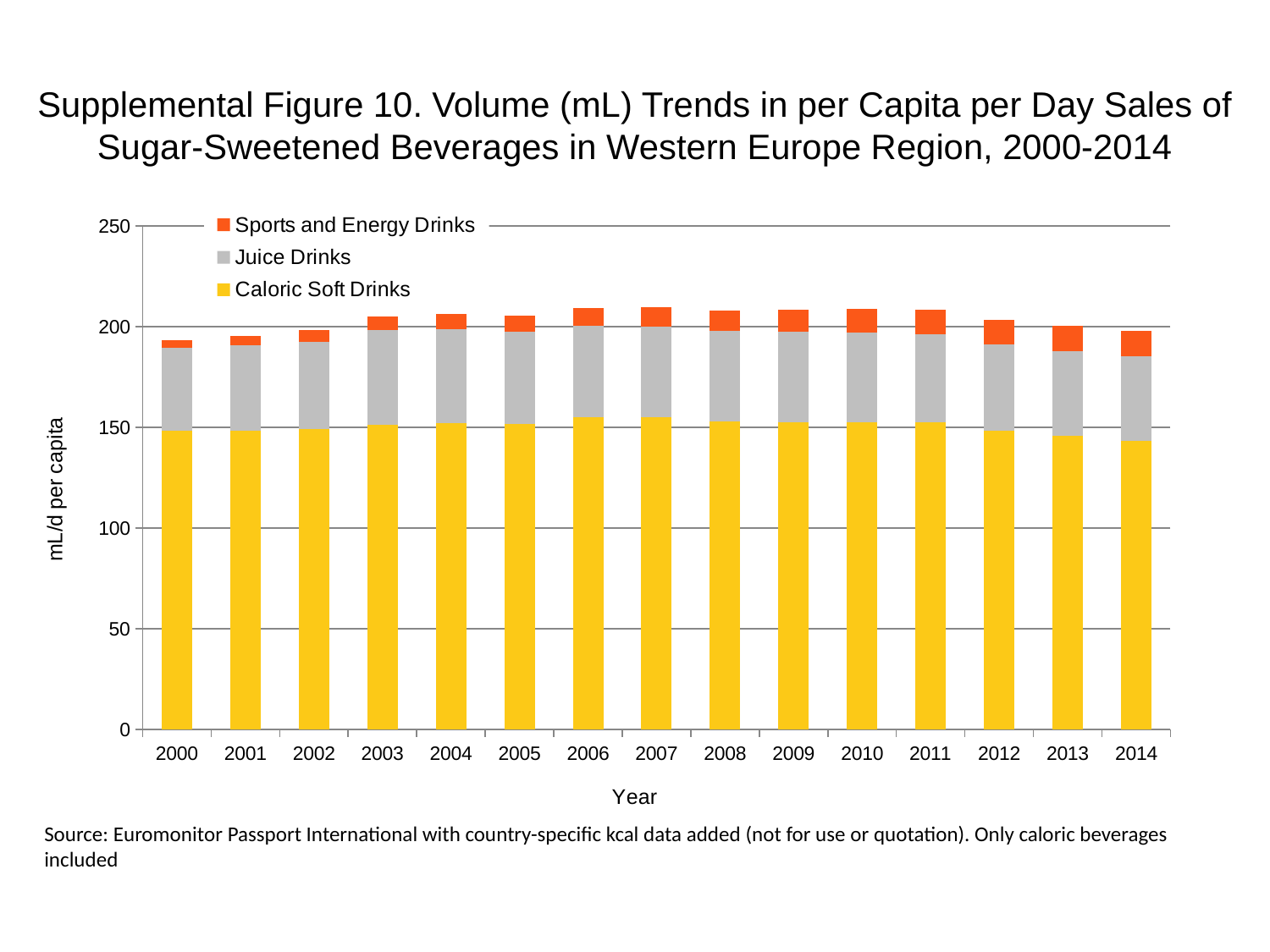
Is the value for Caloric Soft Drinks in 2007 greater or less than 150? greater Is the value for Caloric Soft Drinks in 2014 greater or less than 150? less How many years are shown along the x axis? 15 Is the total stacked bar for 2000 greater or less than 200? less From 2007 to 2014, does the total stacked bar rise or fall? fall Which year has the larger value for Caloric Soft Drinks, 2007 or 2014? 2007 Which year has the larger total stacked bar, 2000 or 2007? 2007 What is the label on the y axis? mL/d per capita Which series is shown at the bottom of each stacked bar? Caloric Soft Drinks How many series does the legend list? 3 What kind of chart is shown on the slide? Stacked bar chart